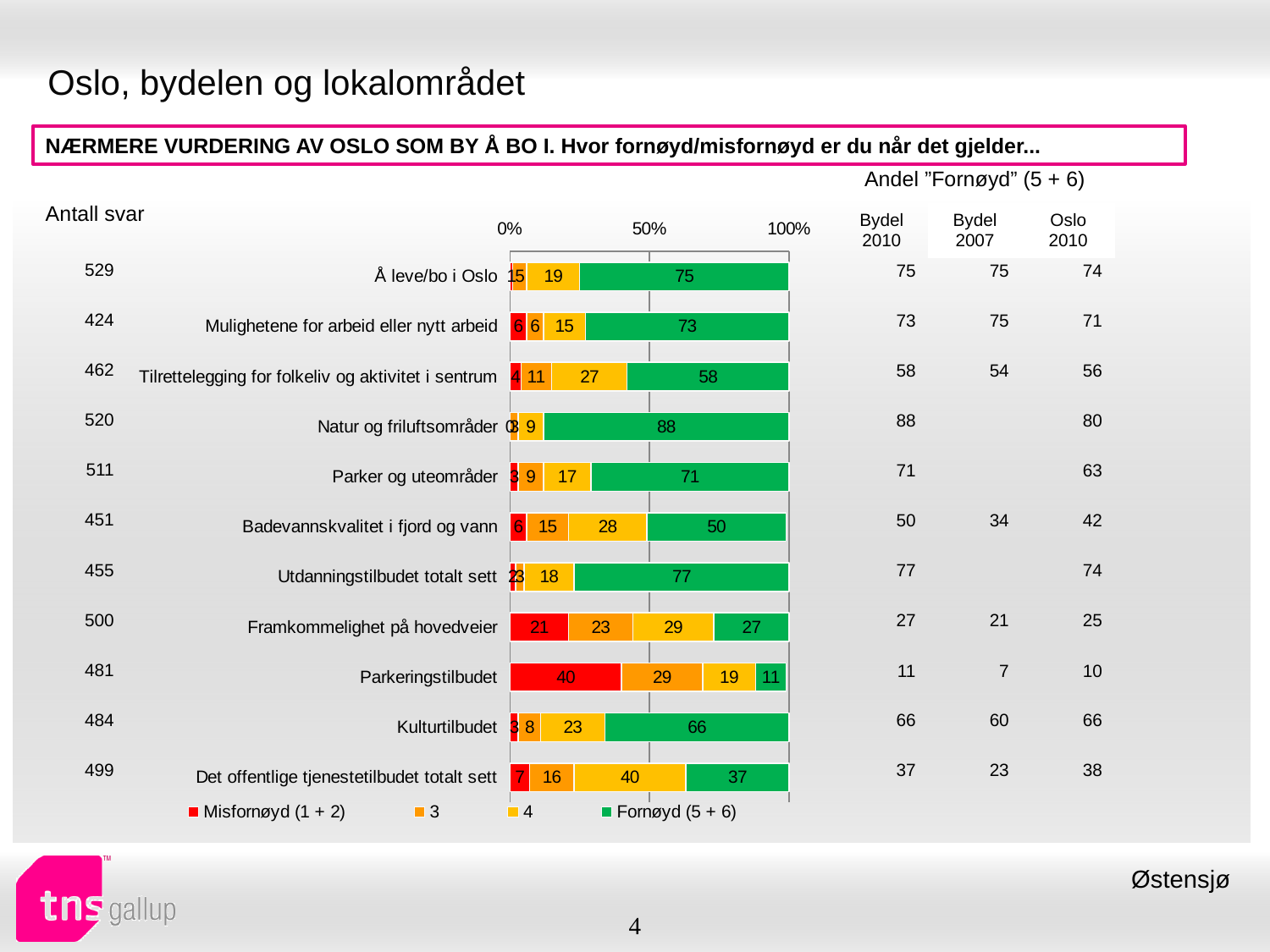
Which has the larger Fornøyd (5 + 6) value, Kulturtilbudet or Badevannskvalitet i fjord og vann? Kulturtilbudet How many series does the chart legend list? 4 What is the total of the stacked bar for Parkeringstilbudet? 99 What is the Misfornøyd (1 + 2) value for Parkeringstilbudet? 40 How many categories (statements) are plotted in the bar chart? 11 What is the Fornøyd (5 + 6) value for Natur og friluftsområder? 88 What kind of chart is shown on the slide? bar chart What is the value of series 3 for Framkommelighet på hovedveier? 23 Which category has the lowest Fornøyd (5 + 6) value? Parkeringstilbudet What is the value of series 4 for Det offentlige tjenestetilbudet totalt sett? 40 Which category has the highest Fornøyd (5 + 6) value? Natur og friluftsområder What is the difference between the Fornøyd (5 + 6) values for Å leve/bo i Oslo and Mulighetene for arbeid eller nytt arbeid? 2